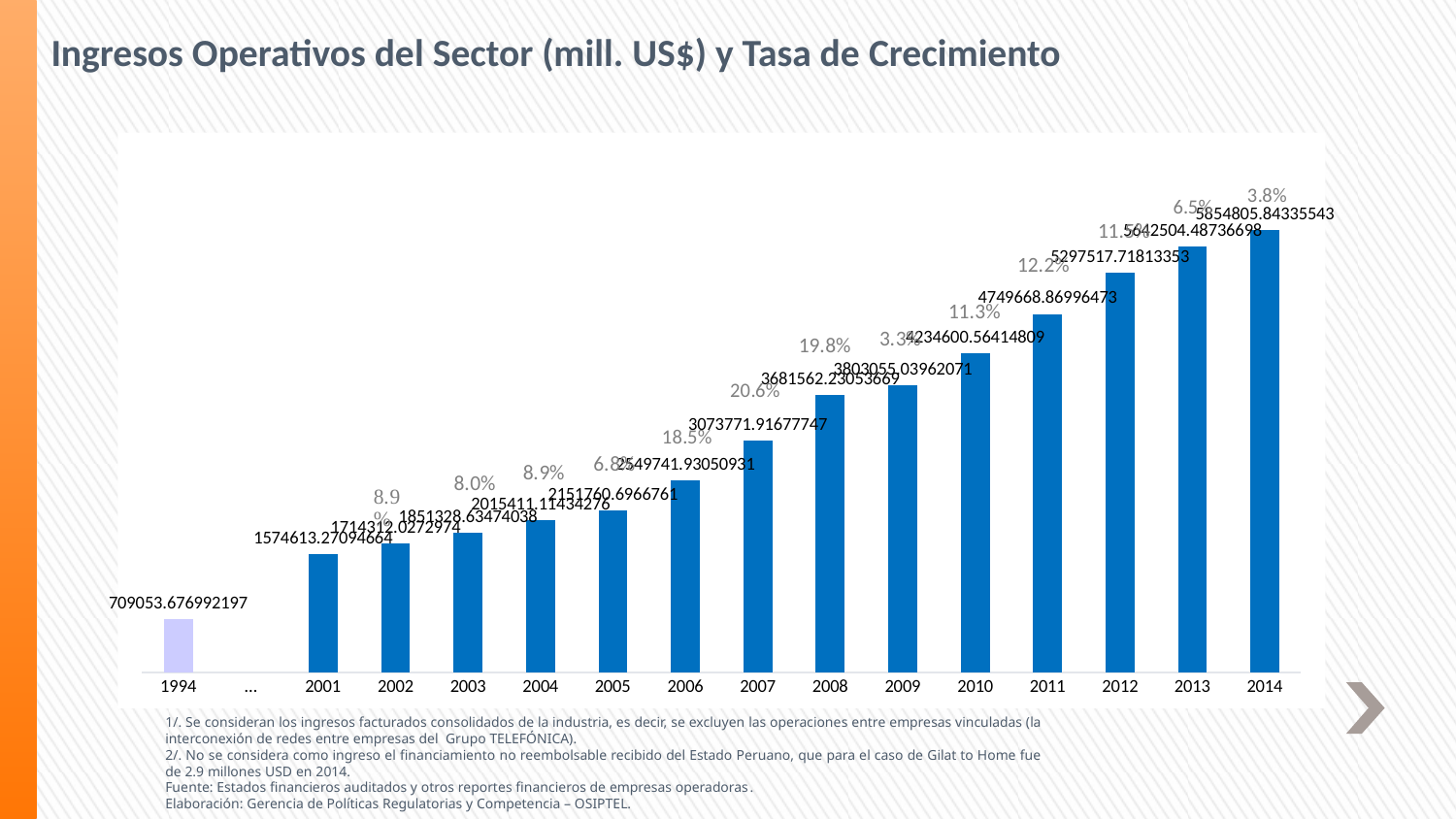
What growth rate is shown above the 2009 bar? 3.3% What growth rate is shown above the 2007 bar? 20.6% What is the operating income value labelled for 1994? 709053.676992197 Do the operating income values rise or fall from 2001 to 2014? rise How many years are plotted as bars in the chart? 15 Which year has the highest operating income? 2014 What is the title of the chart? Ingresos Operativos del Sector (mill. US$) y Tasa de Crecimiento What kind of chart is shown on the slide? bar chart What is the operating income value labelled for 2014? 5854805.84335543 Which year has the lowest operating income? 1994 Which year has the higher operating income, 2008 or 2010? 2010 What is the operating income value labelled for 2011? 4749668.86996473